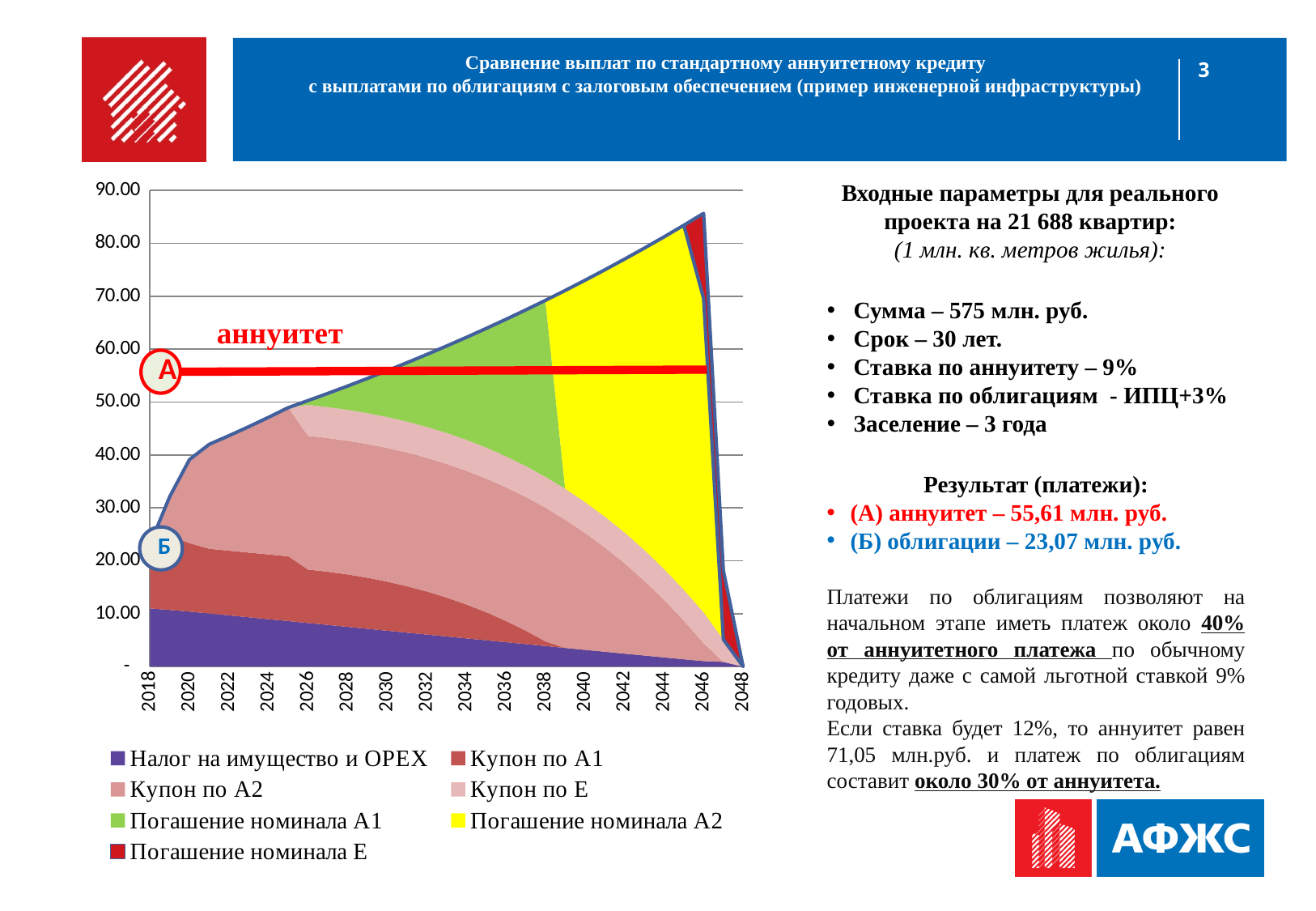
Is the value of the red annuity line (A) greater or less than 60? less How many series does the chart legend list? 7 Is the peak of the stacked area around 2046 greater or less than 80? greater Is the total stacked value in 2018 (point Б) greater or less than 30? less What label is written on the red horizontal line in the chart? аннуитет Which series is shown in yellow in the chart legend? Погашение номинала А2 In 2018, which is higher: the red annuity line (A) or the top of the stacked bond payments (Б)? The annuity line (A) Does the total stacked value rise or fall from 2018 to 2046? Rises What kind of chart is shown on the slide? Stacked area chart How many year labels are shown on the x axis? 16